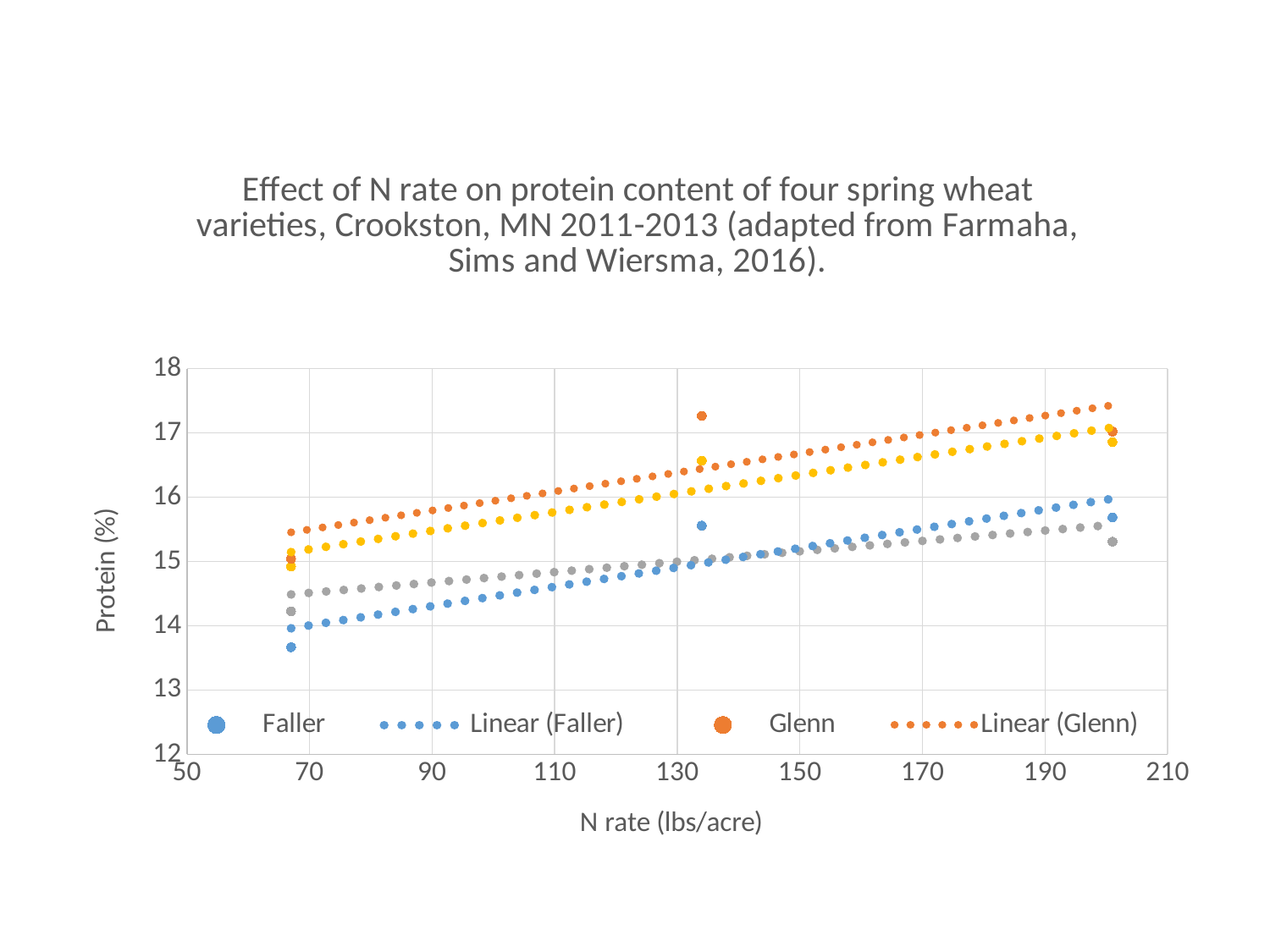
Is the protein value for Faller at the lowest N rate (around 67 lbs/acre) greater or less than 14? less At the middle N rate (around 134 lbs/acre), which variety has the higher protein content, Glenn or Faller? Glenn What kind of chart is shown on the slide? scatter chart Is the protein value for Glenn at the middle N rate (around 134 lbs/acre) greater or less than 17? greater Does the Linear (Glenn) trendline rise or fall as N rate increases? rise What is the label of the x axis? N rate (lbs/acre) What is the label of the y axis? Protein (%) Is the protein value for Faller at the middle N rate (around 134 lbs/acre) greater or less than 15? greater Does the Linear (Faller) trendline rise or fall as N rate increases? rise How many entries does the legend list? 4 How many plotted data points does the Faller series have? 3 At the lowest N rate (around 67 lbs/acre), which variety has the higher protein content, Glenn or Faller? Glenn